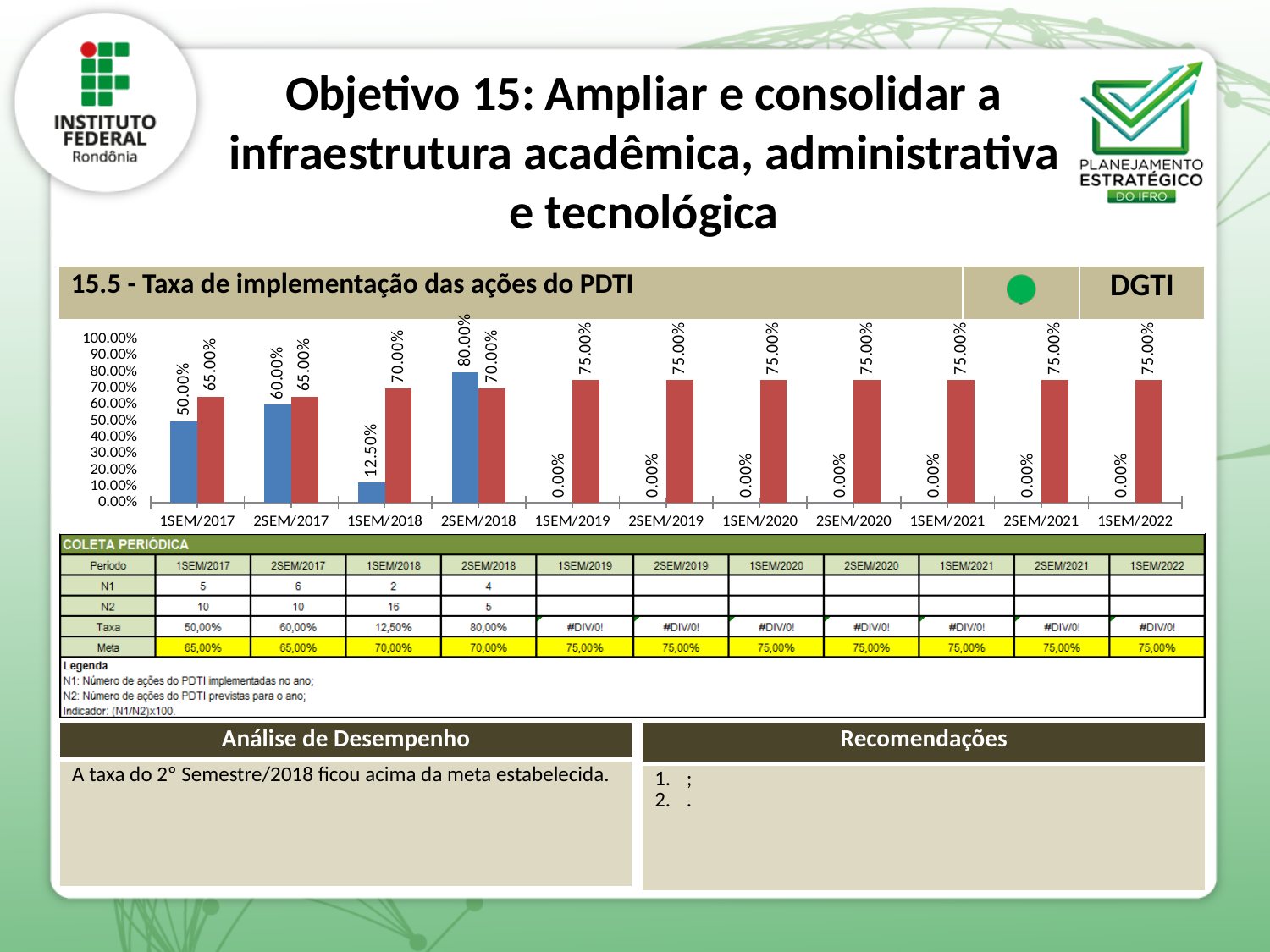
For 1SEM/2017, which is larger, the blue bar or the red bar? the red bar What type of chart is shown under '15.5 - Taxa de implementação das ações do PDTI'? bar chart How many periods are shown on the x axis of the chart? 11 What is the difference between the blue bar and the red bar for 2SEM/2018? 10.00% What is the value of the red bar for 1SEM/2017? 65.00% What is the value of the blue bar for 2SEM/2018? 80.00% What is the value of the red bar for 1SEM/2022? 75.00% Which period has the highest blue bar? 2SEM/2018 What is the value of the blue bar for 1SEM/2018? 12.50% What is the title of the chart? 15.5 - Taxa de implementação das ações do PDTI Do the red bar values rise or fall from 1SEM/2017 to 1SEM/2022? rise What is the difference between the blue bar values for 2SEM/2017 and 1SEM/2018? 47.50%